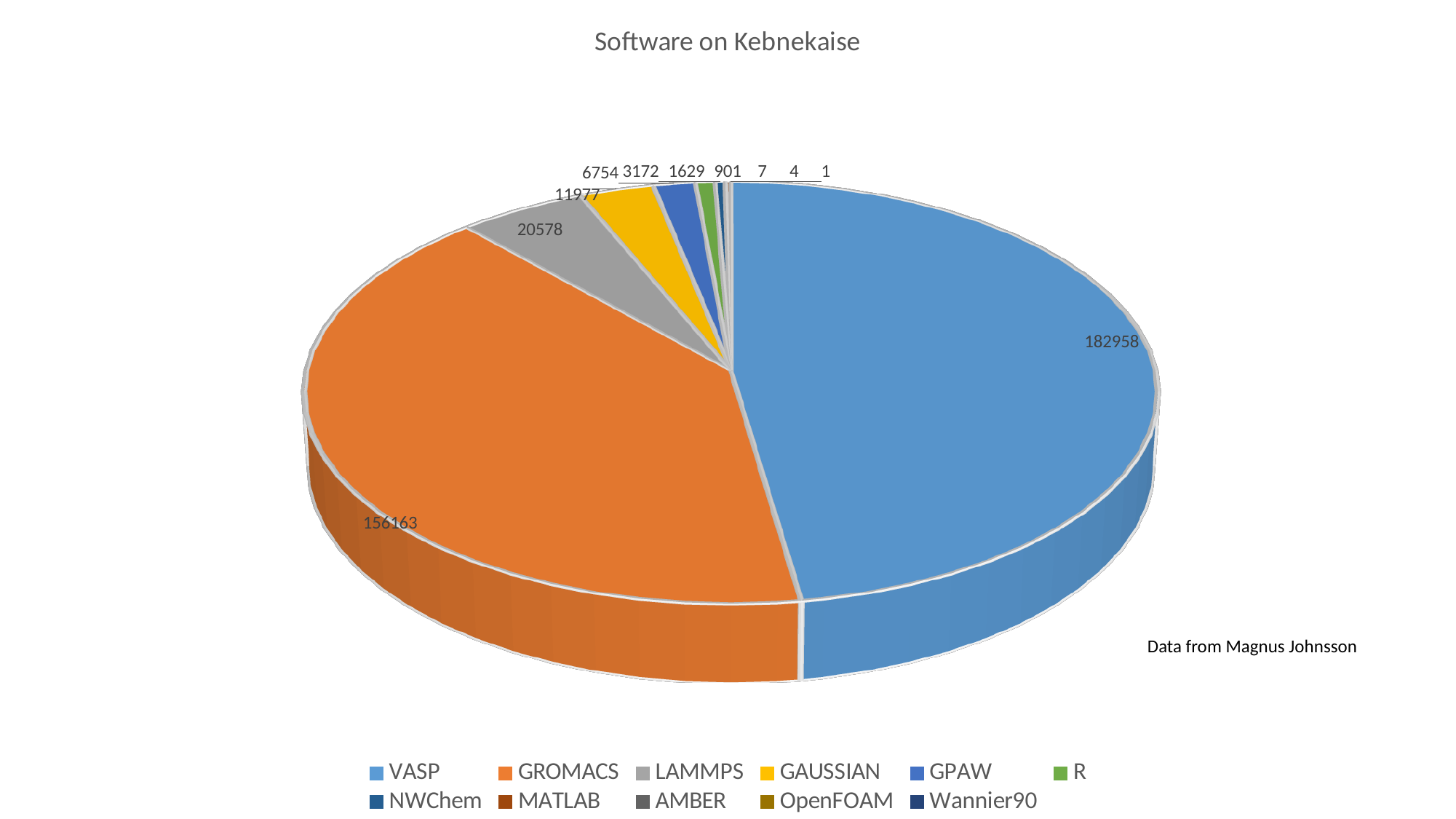
Which is larger, the value for LAMMPS or the value for GAUSSIAN? LAMMPS Which software has the smallest value shown? Wannier90 What is the difference between the values for VASP and GROMACS? 26795 What is the title of the chart? Software on Kebnekaise What colour is the GROMACS slice? orange How many software packages does the legend list? 11 What is the value for LAMMPS? 20578 What kind of chart is shown on the slide? pie chart What is the value for GAUSSIAN? 11977 Which software has the largest slice of the pie? VASP What is the value for GROMACS? 156163 What is the value for VASP? 182958